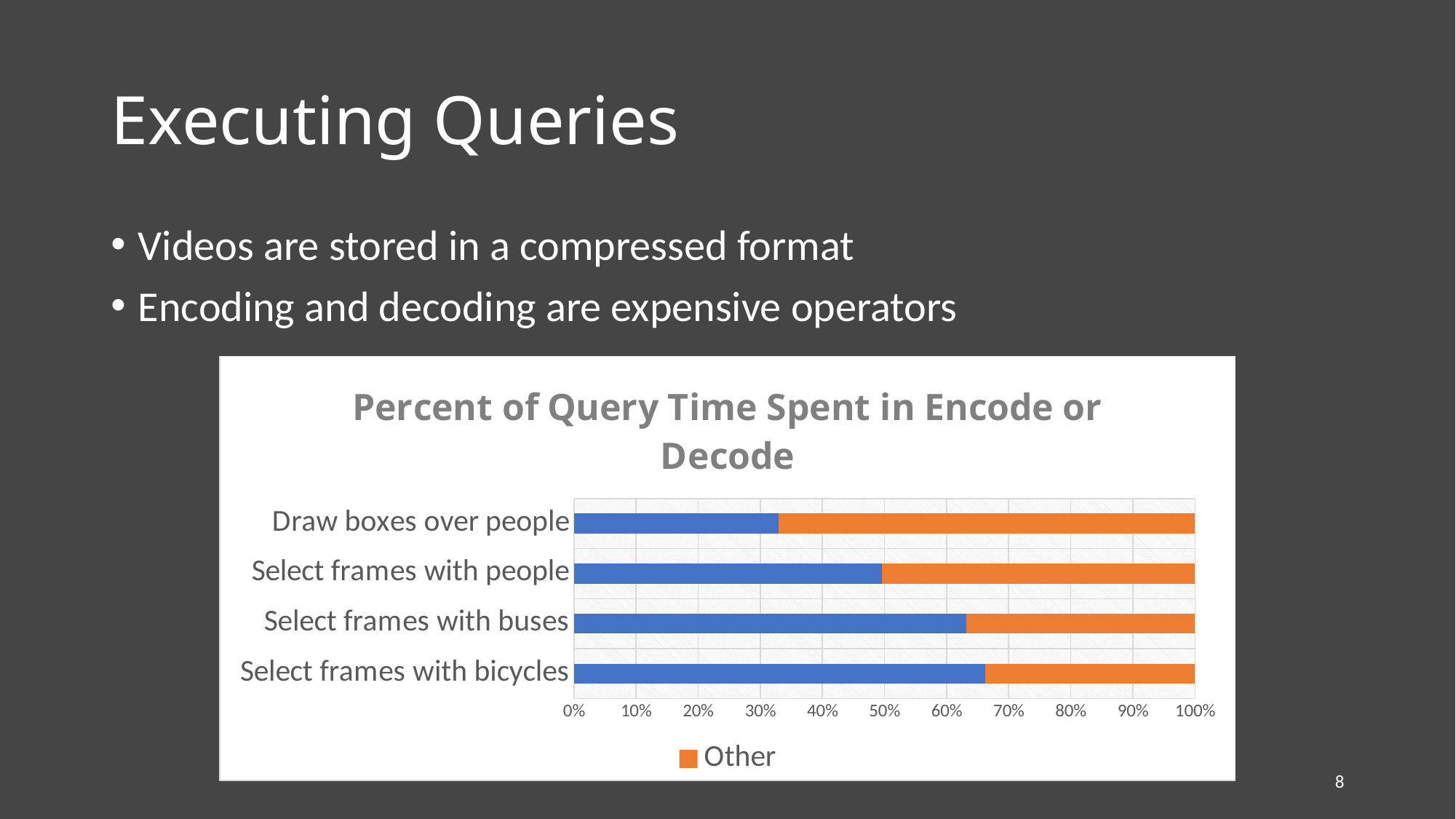
What is the total of the stacked bar for Select frames with buses? 100% Which category has the smallest blue portion? Draw boxes over people How many series does the chart's legend list? 1 Is the blue portion for Draw boxes over people greater or less than 40%? less Is the blue portion for Select frames with bicycles greater or less than 60%? greater What is the title of the chart? Percent of Query Time Spent in Encode or Decode What is the only series name shown in the chart's legend? Other Which has a larger blue portion: Select frames with buses or Select frames with people? Select frames with buses Is the orange (Other) portion for Draw boxes over people greater or less than 60%? greater What kind of chart is shown on the slide? bar chart Which category has the largest orange (Other) portion? Draw boxes over people How many categories (queries) are shown on the chart? 4